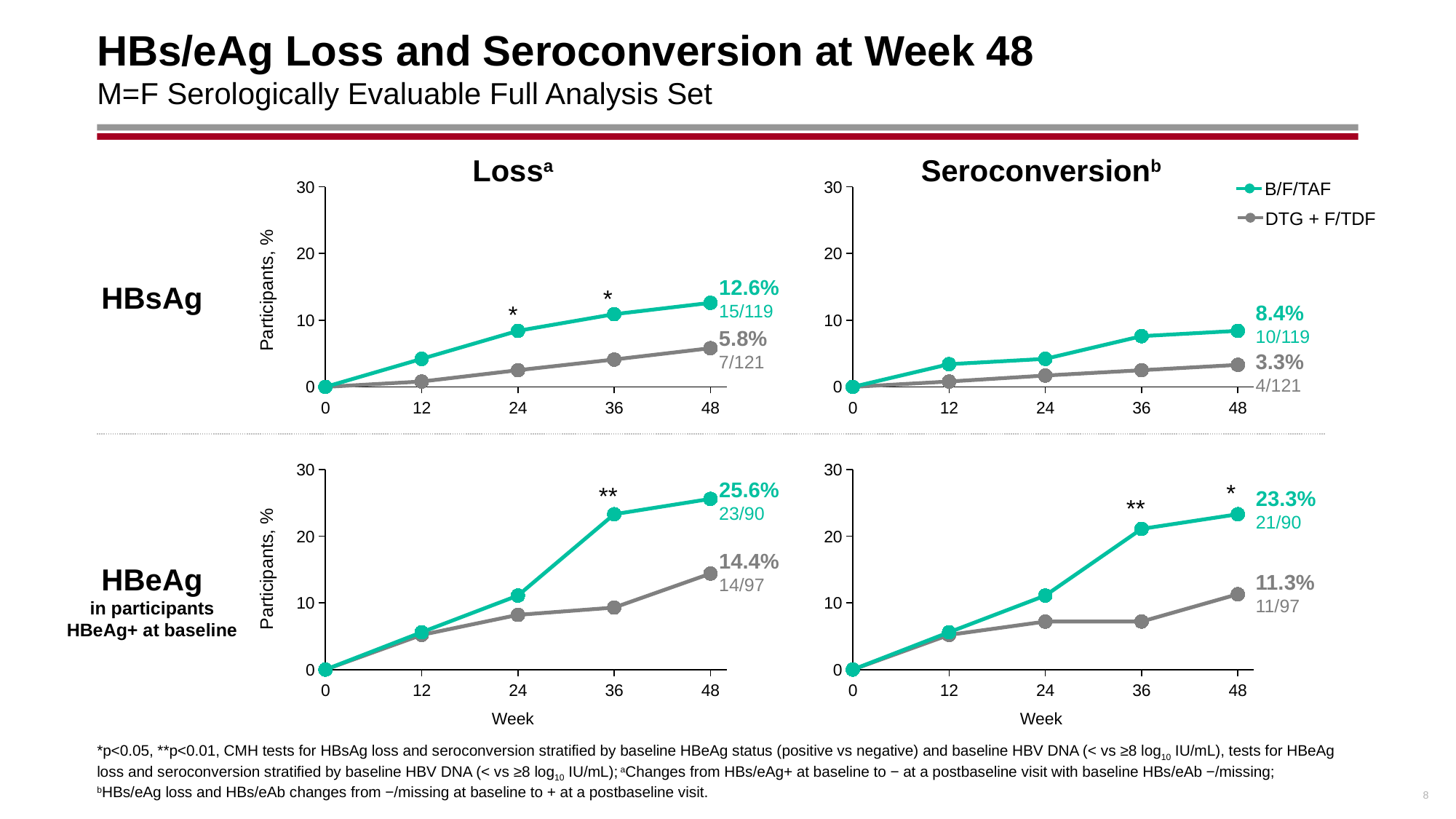
In the HBeAg Loss chart (bottom left), what is the week 48 value for DTG + F/TDF? 14.4% In the HBeAg Loss chart (bottom left), is the value for B/F/TAF at week 36 greater or less than 20? greater How many series does the legend list? 2 In the HBsAg Seroconversion chart (top right), what is the week 48 value for B/F/TAF? 8.4% In the HBsAg Loss chart (top left), what is the week 48 value for B/F/TAF? 12.6% In the HBeAg Seroconversion chart (bottom right), which treatment has the higher value at week 48? B/F/TAF In the HBsAg Seroconversion chart (top right), what is the difference between the week 48 values for B/F/TAF and DTG + F/TDF? 5.1% In the HBsAg Loss chart (top left), what is the week 48 value for DTG + F/TDF? 5.8% What kind of chart is the HBsAg Loss chart (top left)? Line chart In the HBeAg Loss chart (bottom left), what is the difference between the week 48 values for B/F/TAF and DTG + F/TDF? 11.2% In the HBeAg Seroconversion chart (bottom right), what is the week 48 value for B/F/TAF? 23.3% In the HBeAg Seroconversion chart (bottom right), do the B/F/TAF values rise or fall from week 0 to week 48? Rise